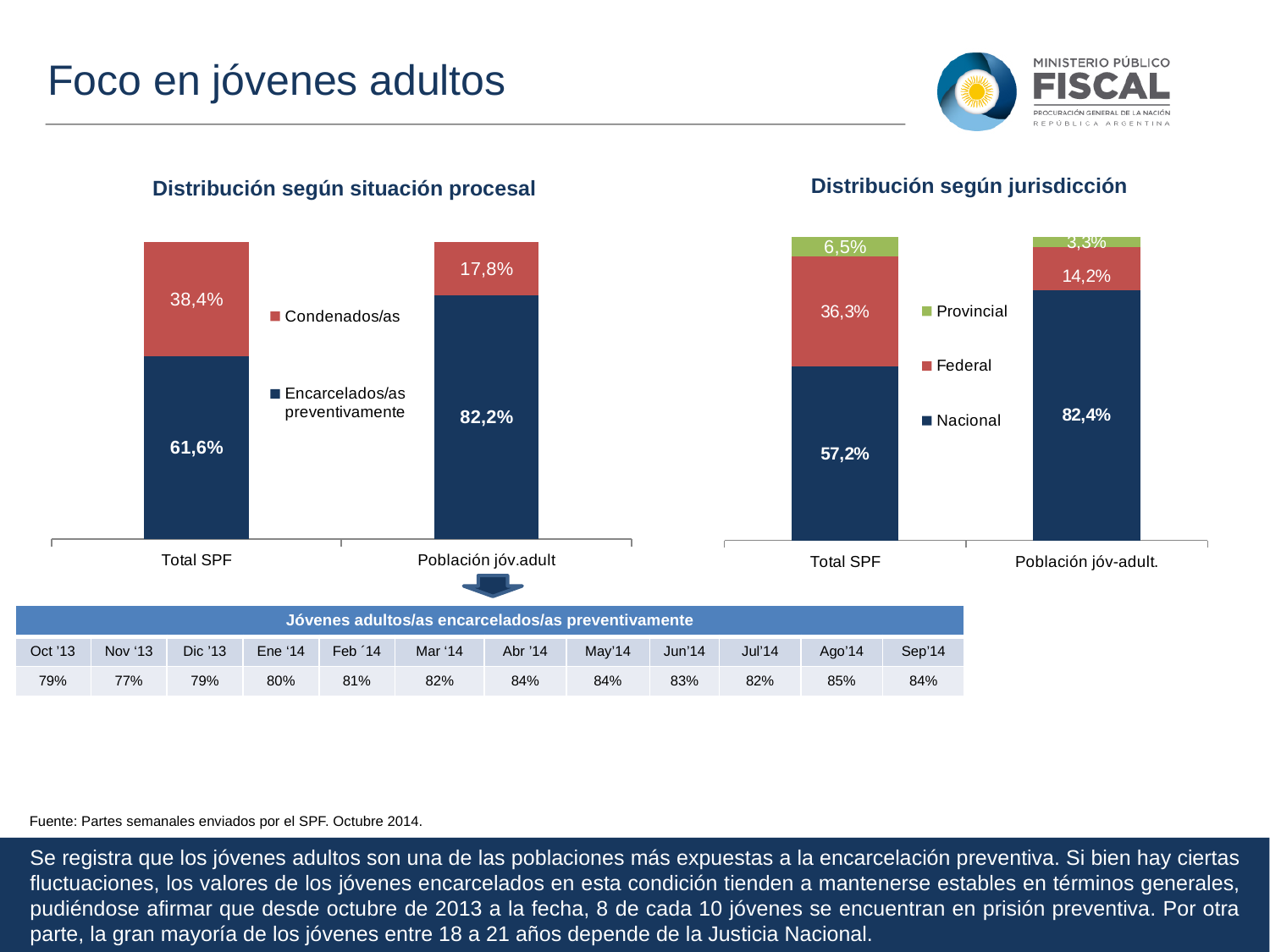
In the 'Distribución según situación procesal' chart, what is the value for Encarcelados/as preventivamente in the Total SPF bar? 61,6% How many series does the legend of the 'Distribución según jurisdicción' chart list? 3 In the 'Distribución según situación procesal' chart, which category has the larger Condenados/as value, Total SPF or Población jóv.adult? Total SPF In the 'Distribución según situación procesal' chart, what is the difference between the Encarcelados/as preventivamente values for Población jóv.adult and Total SPF? 20,6% How many series does the legend of the 'Distribución según situación procesal' chart list? 2 In the 'Distribución según jurisdicción' chart, what is the Nacional value for Población jóv-adult.? 82,4% In the 'Distribución según jurisdicción' chart, what is the Provincial value for Población jóv-adult.? 3,3% In the 'Distribución según jurisdicción' chart, which series has the smallest value in the Total SPF bar? Provincial What kind of chart is 'Distribución según jurisdicción'? Stacked bar chart In the 'Distribución según situación procesal' chart, what is the value for Condenados/as in the Población jóv.adult bar? 17,8% In the 'Distribución según jurisdicción' chart, what is the Federal value for Total SPF? 36,3% In the 'Distribución según jurisdicción' chart, what is the difference between the Federal values for Total SPF and Población jóv-adult.? 22,1%